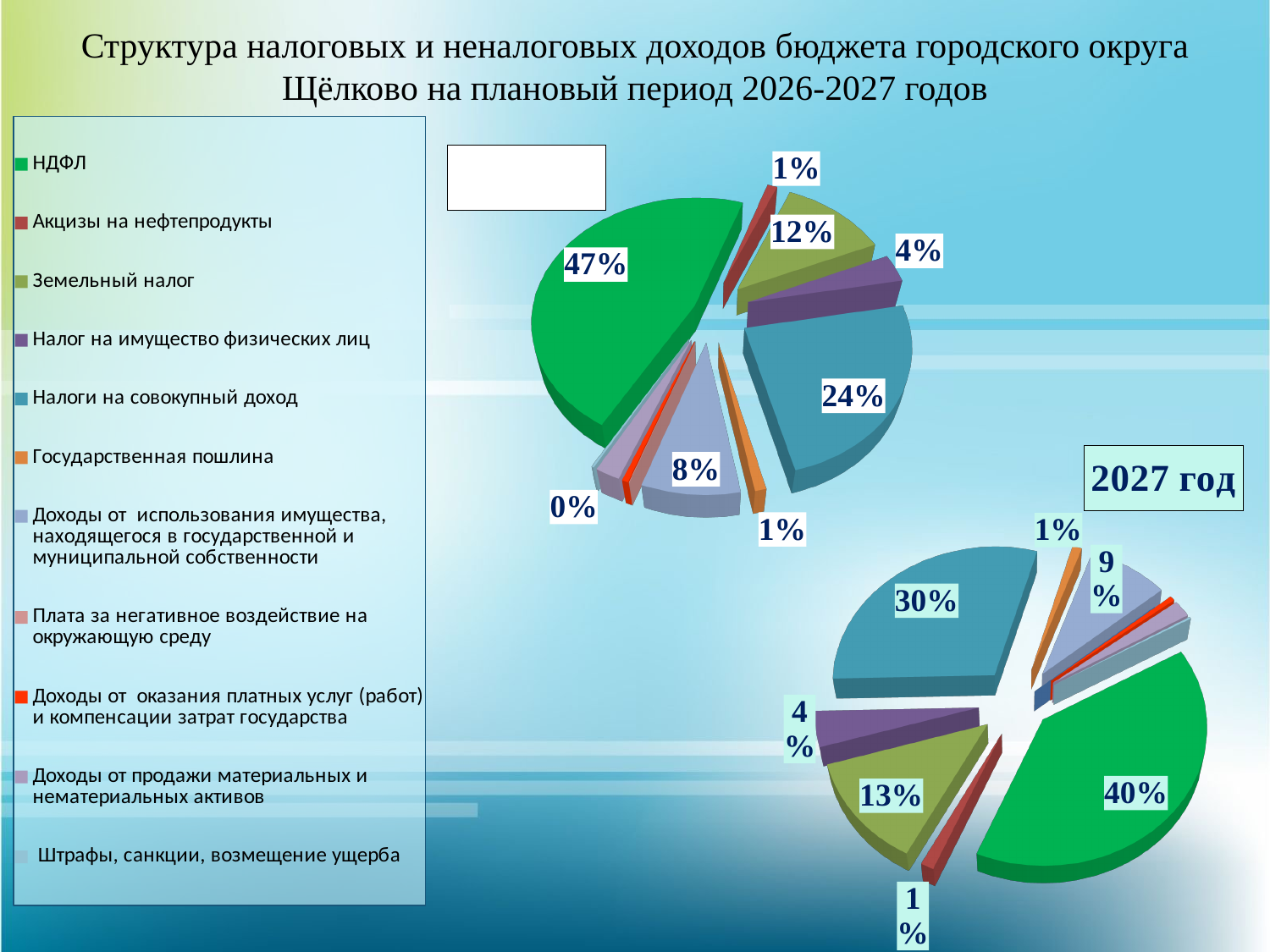
In the 2027 год chart, which category has the largest slice? НДФЛ In the upper pie chart, what share does Земельный налог have? 12% What year label is shown next to the lower pie chart? 2027 год How many categories does the legend on the slide list? 11 In the upper pie chart, what is the difference in percentage points between НДФЛ and Налоги на совокупный доход? 23 percentage points In the 2027 год chart, what share does НДФЛ have? 40% What kind of chart is the upper chart on the slide? pie chart In the 2027 год chart, which is larger: Земельный налог or Налог на имущество физических лиц? Земельный налог In the upper pie chart, what share does Доходы от использования имущества, находящегося в государственной и муниципальной собственности have? 8% In the 2027 год chart, what share does Налоги на совокупный доход have? 30% In the 2027 год chart, what share does Земельный налог have? 13% In the upper pie chart, what share does Налоги на совокупный доход have? 24%